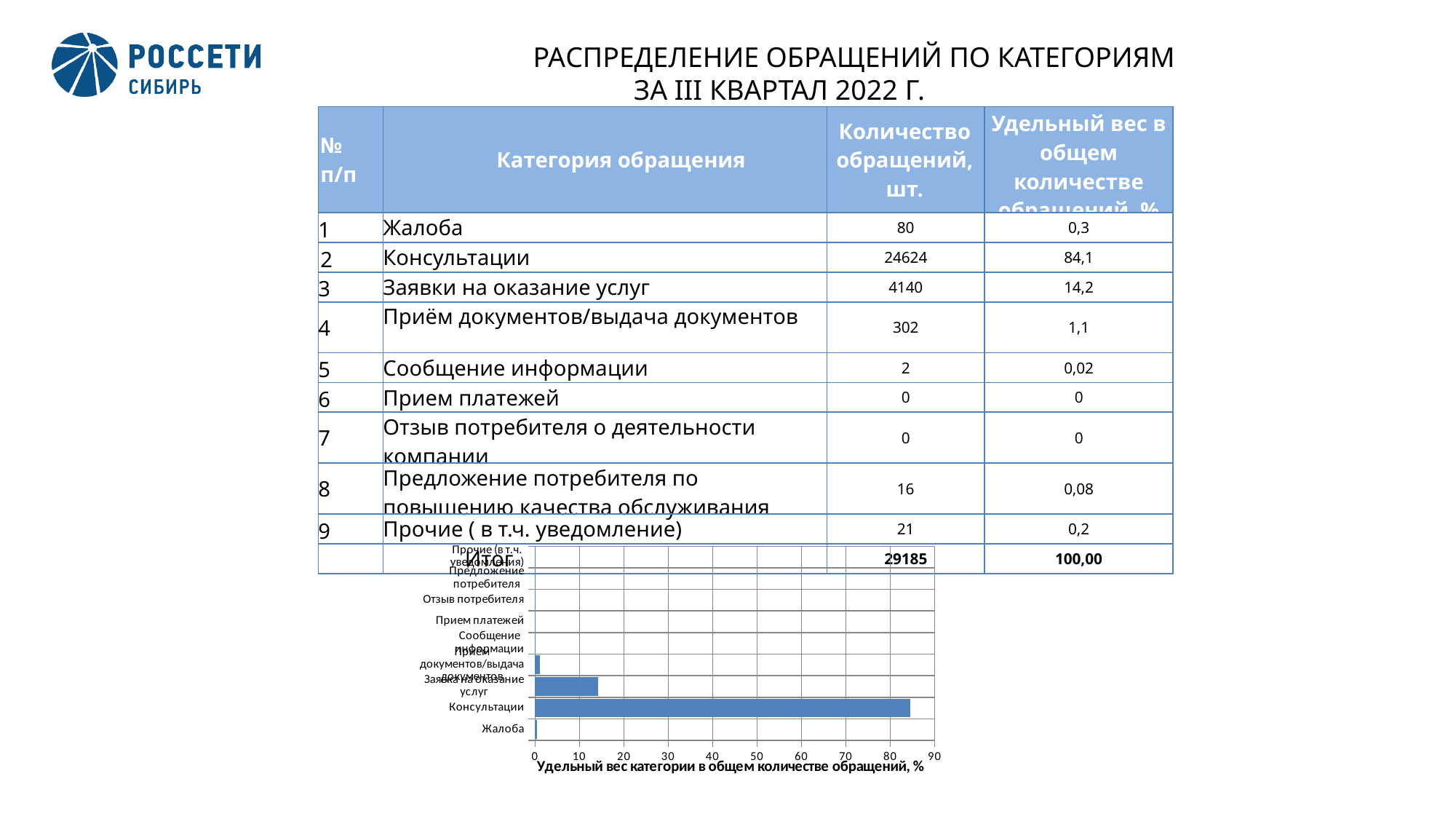
Is the bar for Заявка на оказание услуг greater or less than 10? greater What kind of chart is shown at the bottom of the slide? bar chart Using the table values, what is the difference in share between Консультации and Заявки на оказание услуг? 69,9 What is the highest tick value shown on the horizontal axis of the chart? 90 According to the table, what is the share (удельный вес) of Заявки на оказание услуг? 14,2 Which category has the longest bar in the chart? Консультации How many categories are listed on the vertical axis of the bar chart? 9 Is the bar for Заявка на оказание услуг greater or less than 20? less According to the table, what is the share (удельный вес) of Консультации in the total number of appeals? 84,1 Is the bar for Консультации greater or less than 80? greater Which bar is longer: Консультации or Заявка на оказание услуг? Консультации What is the title of the horizontal axis of the bar chart? Удельный вес категории в общем количестве обращений, %